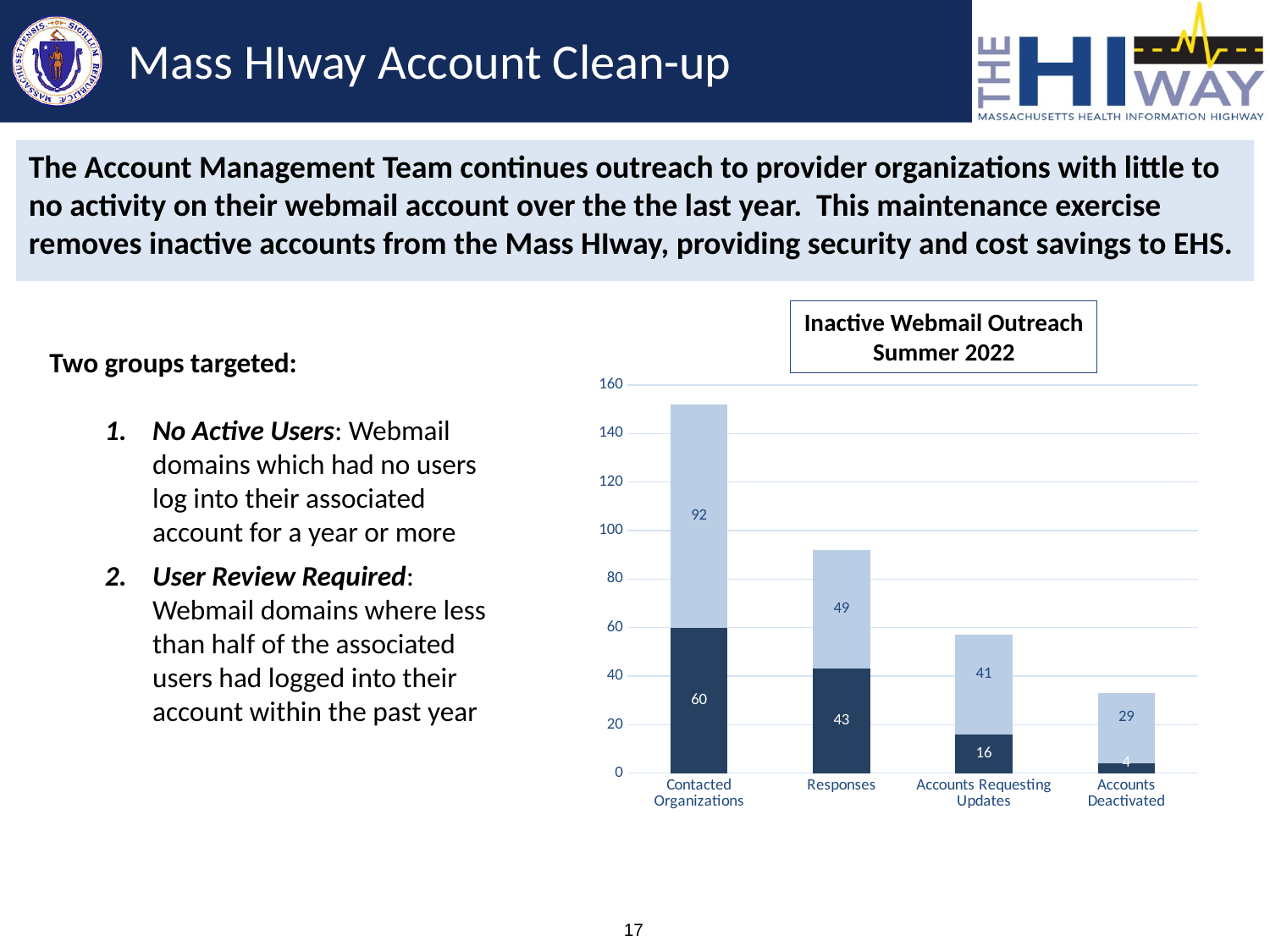
What is the total of the stacked bar for Contacted Organizations? 152 What is the total of the stacked bar for Accounts Requesting Updates? 57 Which category has the lowest total bar? Accounts Deactivated What is the value of the dark blue segment for Accounts Deactivated? 4 What is the title of the chart? Inactive Webmail Outreach Summer 2022 How many categories are shown on the x axis of the chart? 4 Which category has the highest total bar? Contacted Organizations What is the value of the dark blue segment for Contacted Organizations? 60 What is the value of the light blue segment for Responses? 49 What is the difference between the light blue segment values for Contacted Organizations and Responses? 43 What kind of chart is shown on the slide? stacked bar chart Is the total bar for Responses greater or less than 100? less